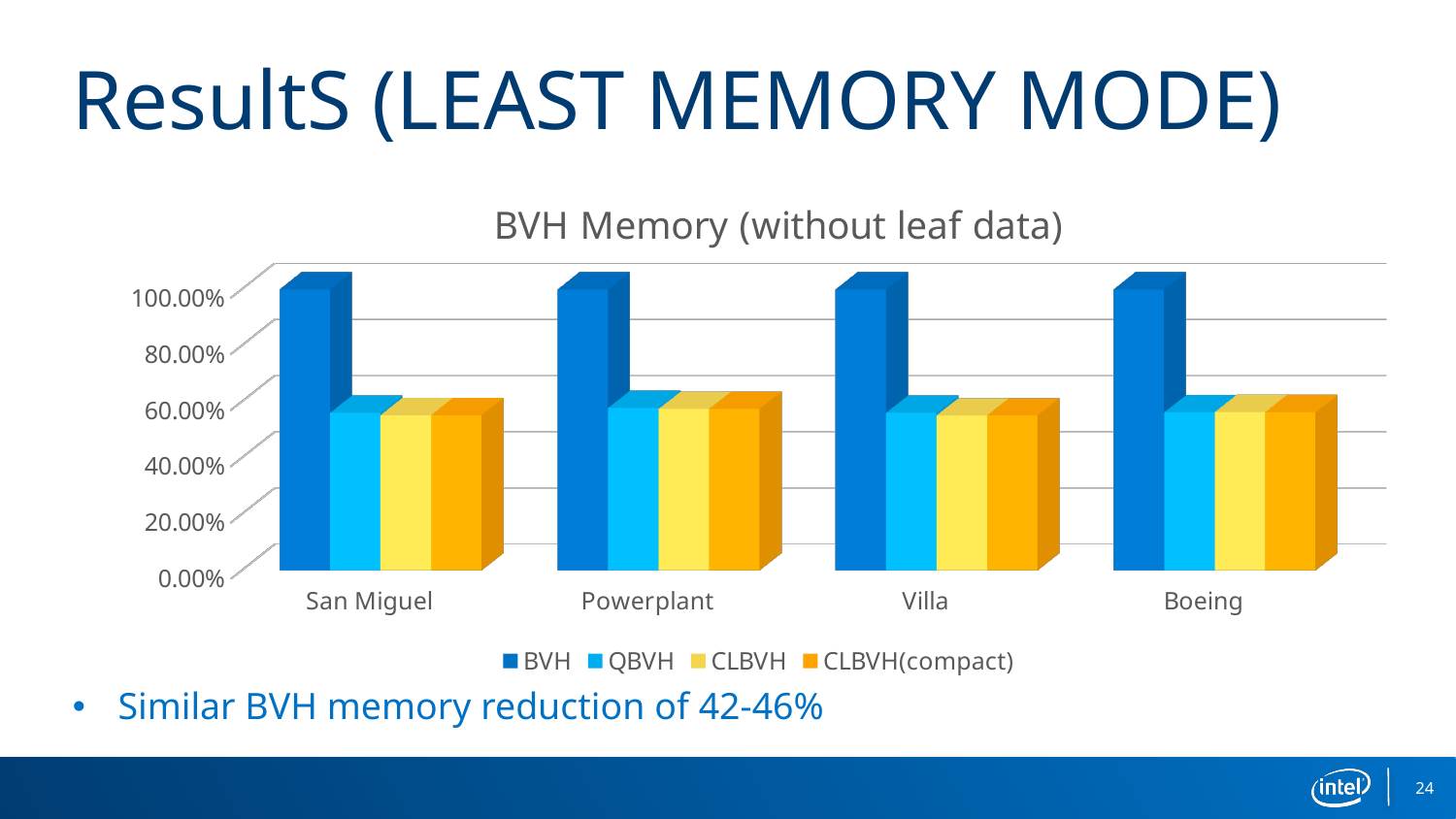
What is the title of the chart? BVH Memory (without leaf data) Is the value for BVH in Villa greater or less than 80.00%? greater Which series has the highest value for San Miguel? BVH Which series is shown in the darkest blue colour in the chart? BVH How many scene categories are shown on the x axis of the chart? 4 What kind of chart is shown on the slide? bar chart For Boeing, which is larger: the BVH value or the QBVH value? BVH How many series does the chart legend list? 4 Is the value for CLBVH in Powerplant greater or less than 80.00%? less Which series has the highest value for Boeing? BVH Is the value for CLBVH(compact) in Villa greater or less than 40.00%? greater